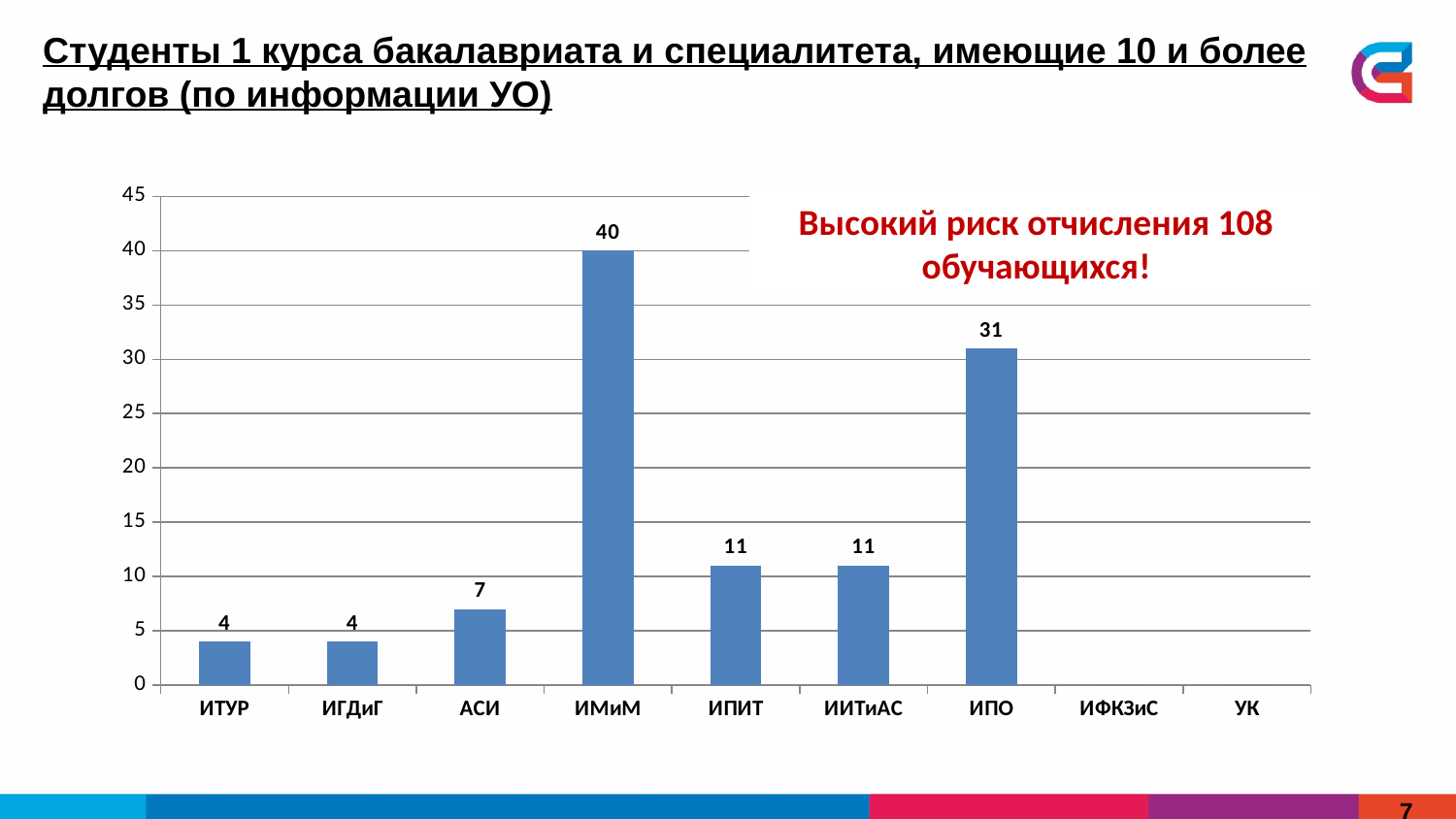
What is the difference between the values for ИПИТ and ИТУР? 7 What is the value for АСИ? 7 What is the difference between the values for ИМиМ and ИПО? 9 What is the value for ИПИТ? 11 Which category has the highest value? ИМиМ What is the value for ИПО? 31 How many categories are shown on the x axis? 9 What is the value for ИМиМ? 40 Which is larger, the value for ИПО or the value for ИИТиАС? ИПО Is the value for ИПО greater or less than 30? greater What number of students is mentioned in the red text on the chart as being at high risk of expulsion? 108 What kind of chart is shown on the slide? bar chart